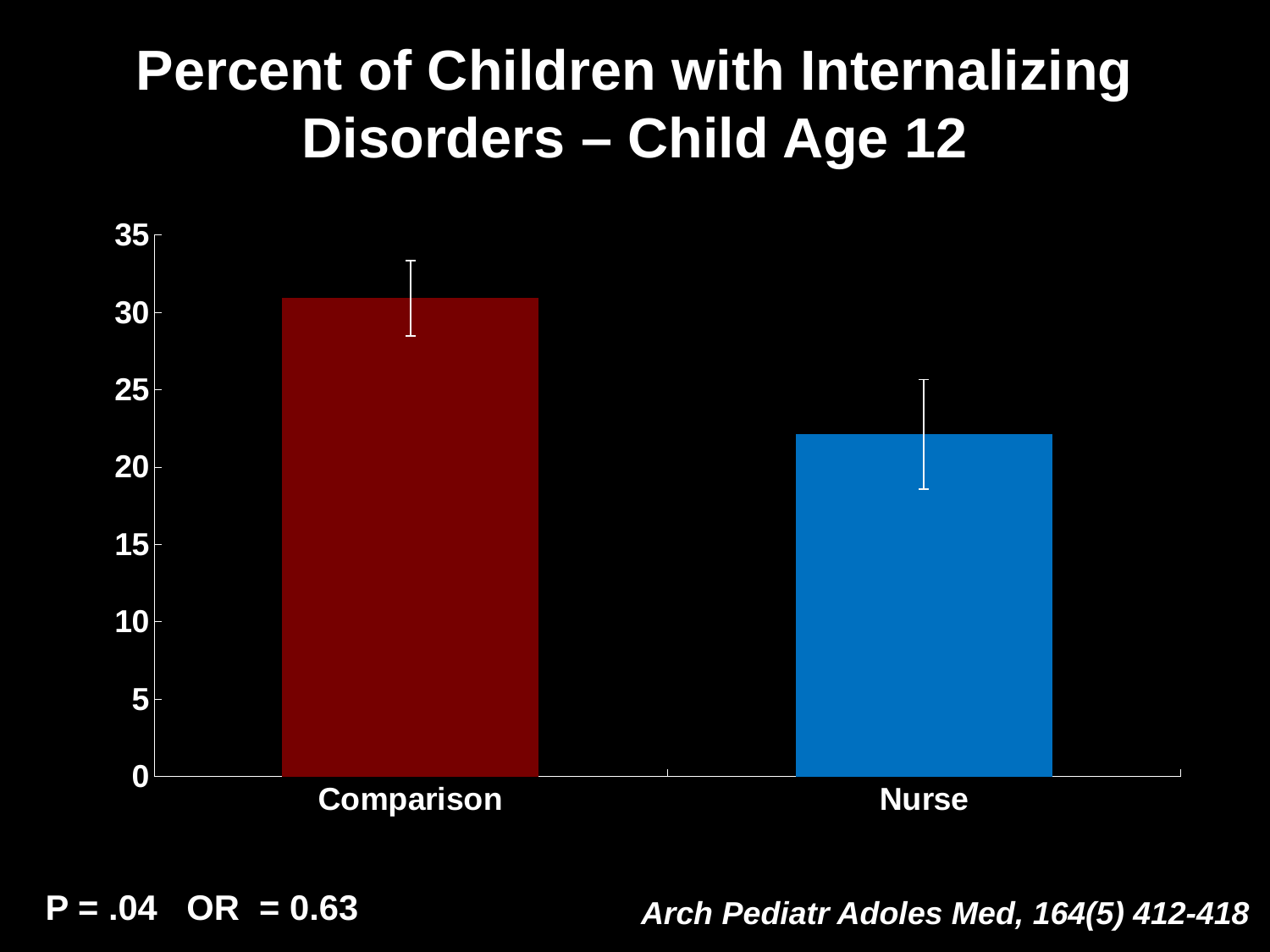
Which is larger, the value for Comparison or the value for Nurse? Comparison What colour is the bar for Nurse? blue Is the value for Comparison greater or less than 35? less How many categories are plotted on the x axis? 2 Which category has the lowest percentage of children with internalizing disorders? Nurse Which category has the highest percentage of children with internalizing disorders? Comparison What is the title of the chart? Percent of Children with Internalizing Disorders – Child Age 12 Is the value for Comparison greater or less than 25? greater Is the value for Nurse greater or less than 20? greater What kind of chart is shown on the slide? bar chart